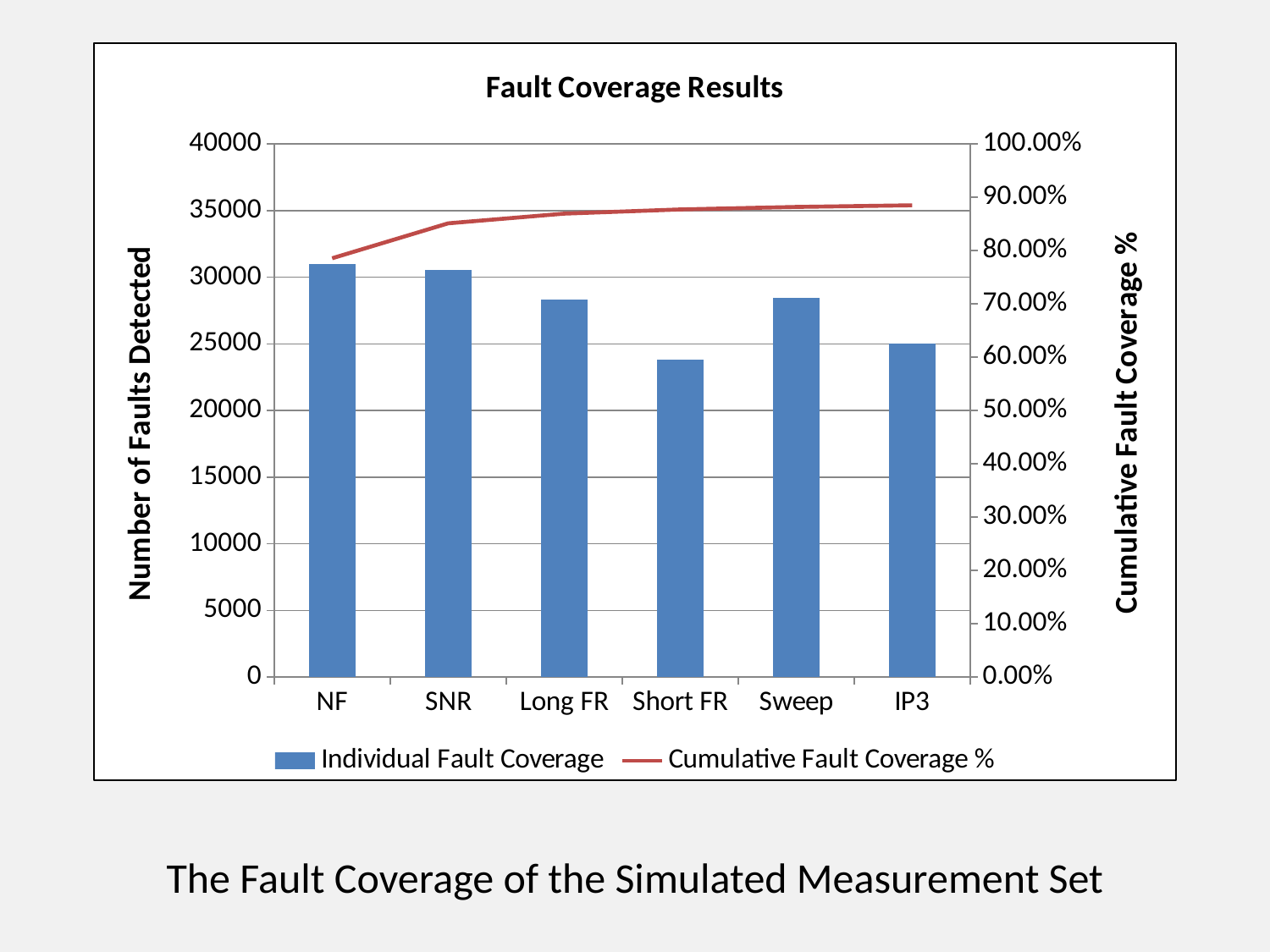
Which has a larger Individual Fault Coverage bar, NF or IP3? NF Is the Cumulative Fault Coverage % at NF greater or less than 80.00%? less Which category has the lowest Individual Fault Coverage bar? Short FR Does the Cumulative Fault Coverage % line rise or fall from NF to IP3? rise What kind of chart is used for the Individual Fault Coverage series? Bar chart Is the Individual Fault Coverage value for Short FR greater or less than 25000? less How many series does the chart's legend list? 2 Is the Individual Fault Coverage value for Sweep greater or less than 25000? greater What is the title of the chart? Fault Coverage Results What is the label of the left vertical axis? Number of Faults Detected How many categories are shown on the x axis of the chart? 6